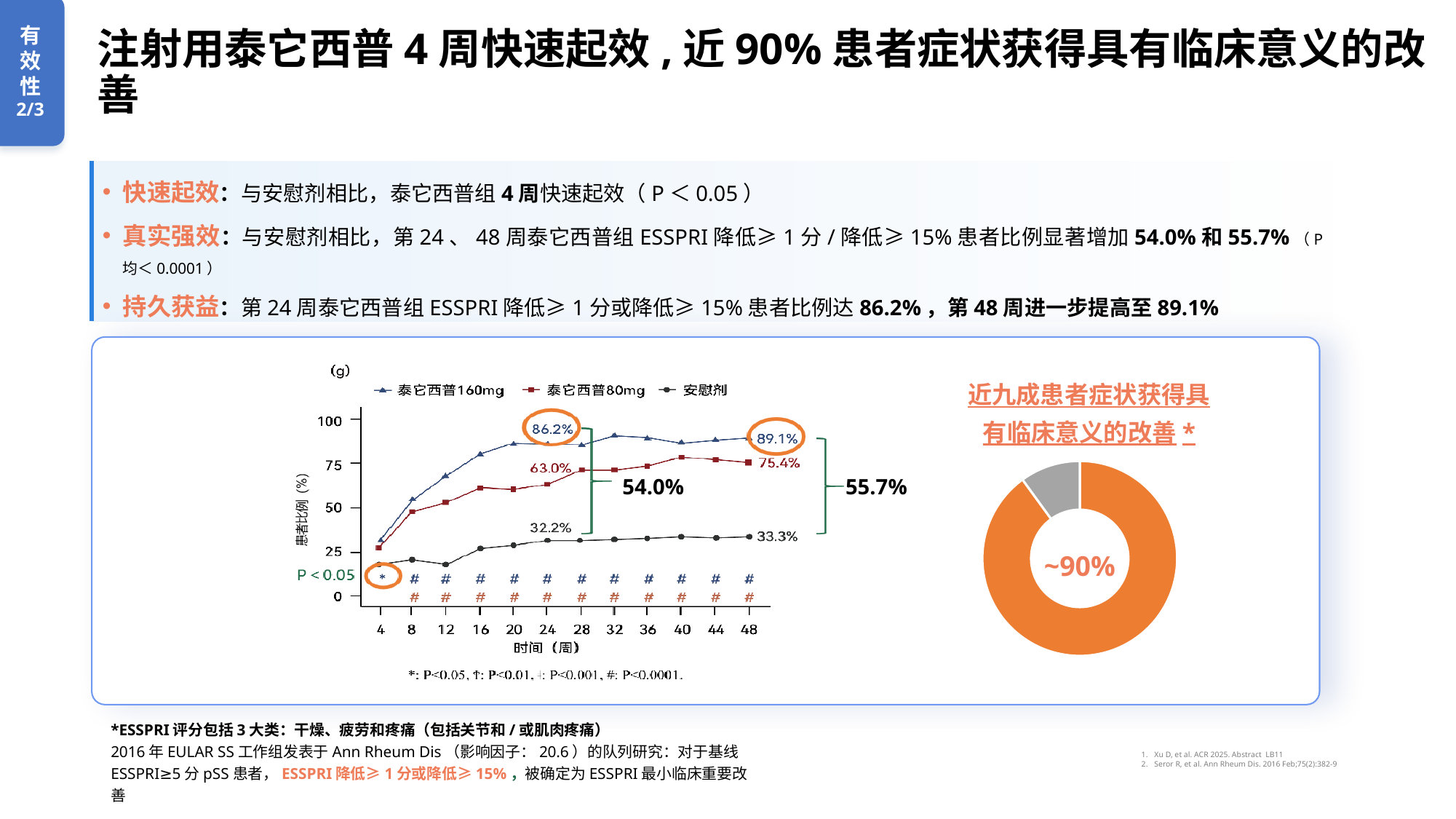
In the line chart on the left, what is the value for 泰它西普160mg at week 48? 89.1% In the line chart on the left, what is the value for 安慰剂 at week 48? 33.3% In the line chart on the left, what is the difference between 泰它西普160mg and 安慰剂 at week 24? 54.0% What type of chart is the chart on the left of the slide? line chart In the line chart on the left, what is the value for 泰它西普80mg at week 24? 63.0% In the line chart on the left, how many series does the legend list? 3 In the line chart on the left, which is larger at week 24: 泰它西普160mg or 泰它西普80mg? 泰它西普160mg In the donut chart on the right, what value is printed in the centre? ~90% In the line chart on the left, is the value for 安慰剂 at week 4 greater or less than 50? less In the line chart on the left, what is the value for 泰它西普160mg at week 24? 86.2% In the line chart on the left, which series has the highest value at week 48? 泰它西普160mg In the line chart on the left, what is the difference between 泰它西普80mg and 安慰剂 at week 24? 30.8%